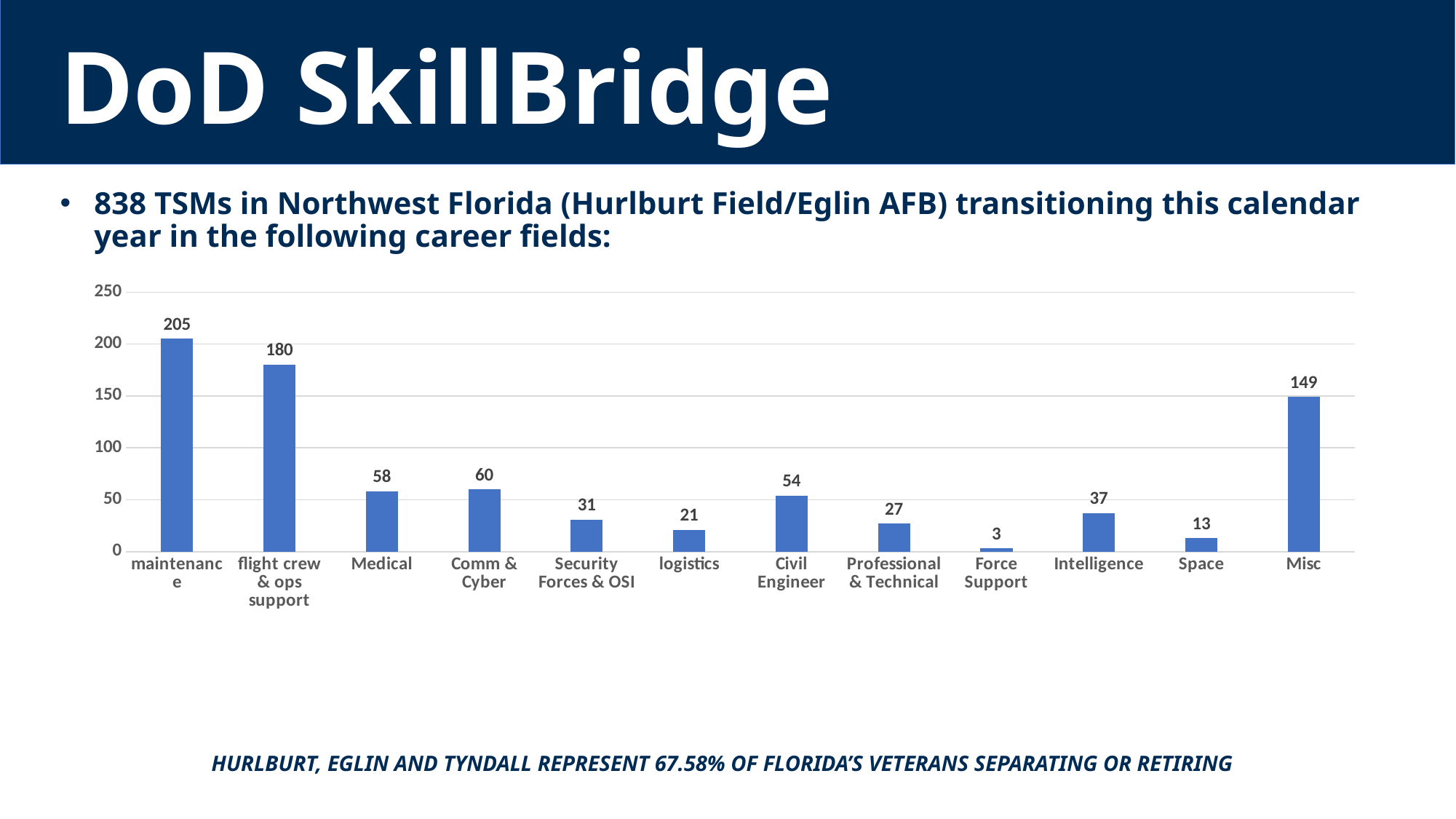
Which career field has the lowest value? Force Support What is the difference between the values for Security Forces & OSI and logistics? 10 What is the value for Intelligence? 37 What is the highest value shown on the vertical axis? 250 How many career fields are shown on the chart? 12 What kind of chart is shown on the slide? bar chart Is the value for Misc greater or less than 100? greater What is the value for Medical? 58 Which career field has the highest value? maintenance Which is larger, the value for Comm & Cyber or the value for Civil Engineer? Comm & Cyber What is the difference between the values for maintenance and flight crew & ops support? 25 What is the value for Misc? 149